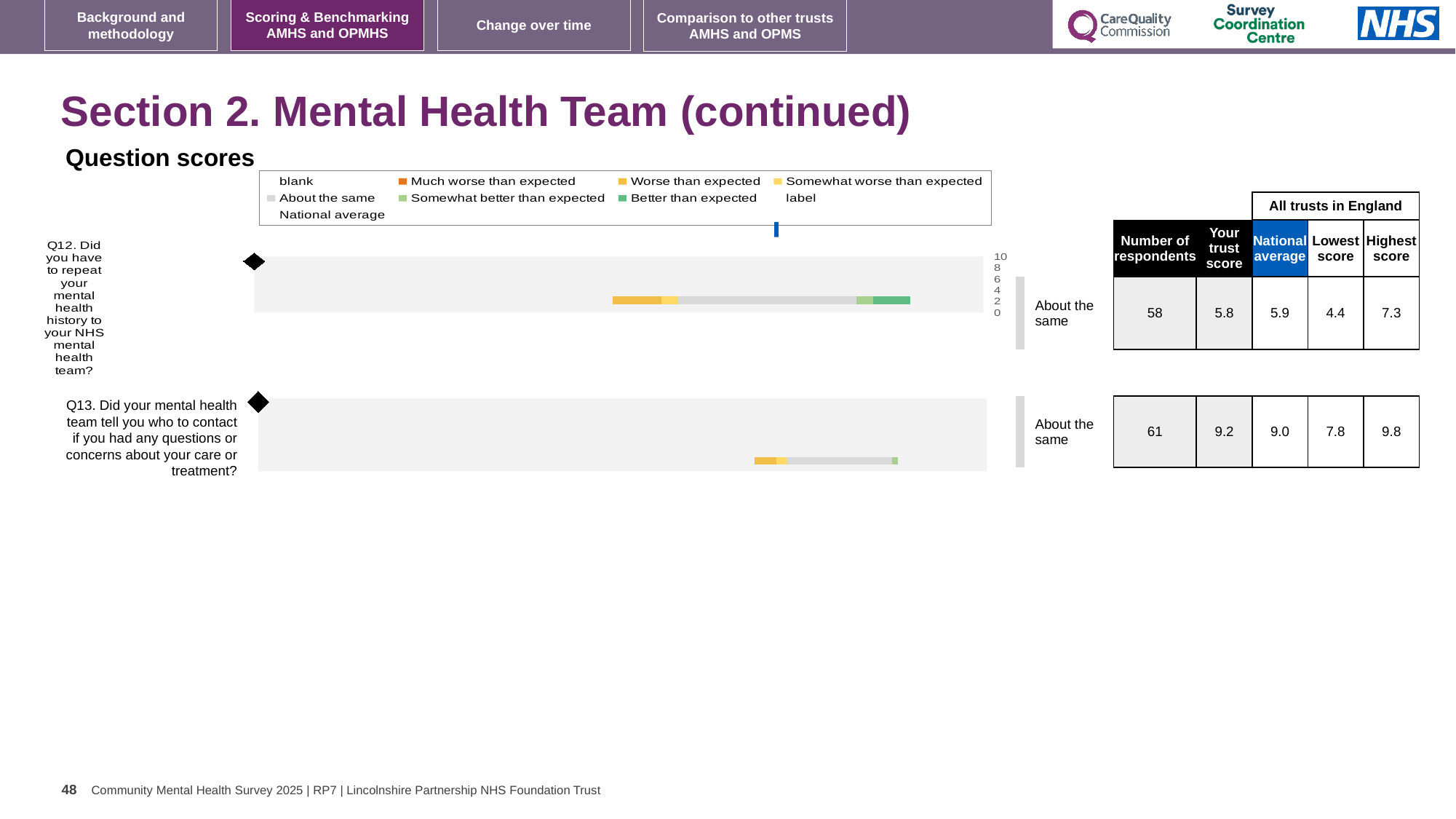
What benchmark category is shown next to the Q12 chart? About the same For Q12, what is the difference between the highest score and the lowest score across all trusts in England? 2.9 For Q13, what is the highest score across all trusts in England? 9.8 For Q13, how many respondents are shown in the table? 61 In the legend, what colour represents 'Much worse than expected'? orange For Q12 (repeating mental health history), what is the trust score shown in the table? 5.8 For Q13, which is larger: the trust score or the national average? trust score For Q12, what is the national average shown in the table? 5.9 How many questions (charts) are shown on the slide? 2 How many entries does the legend list? 9 For Q13 (told who to contact), what is the trust score shown in the table? 9.2 What kind of chart is used to show the benchmark range for Q12? bar chart